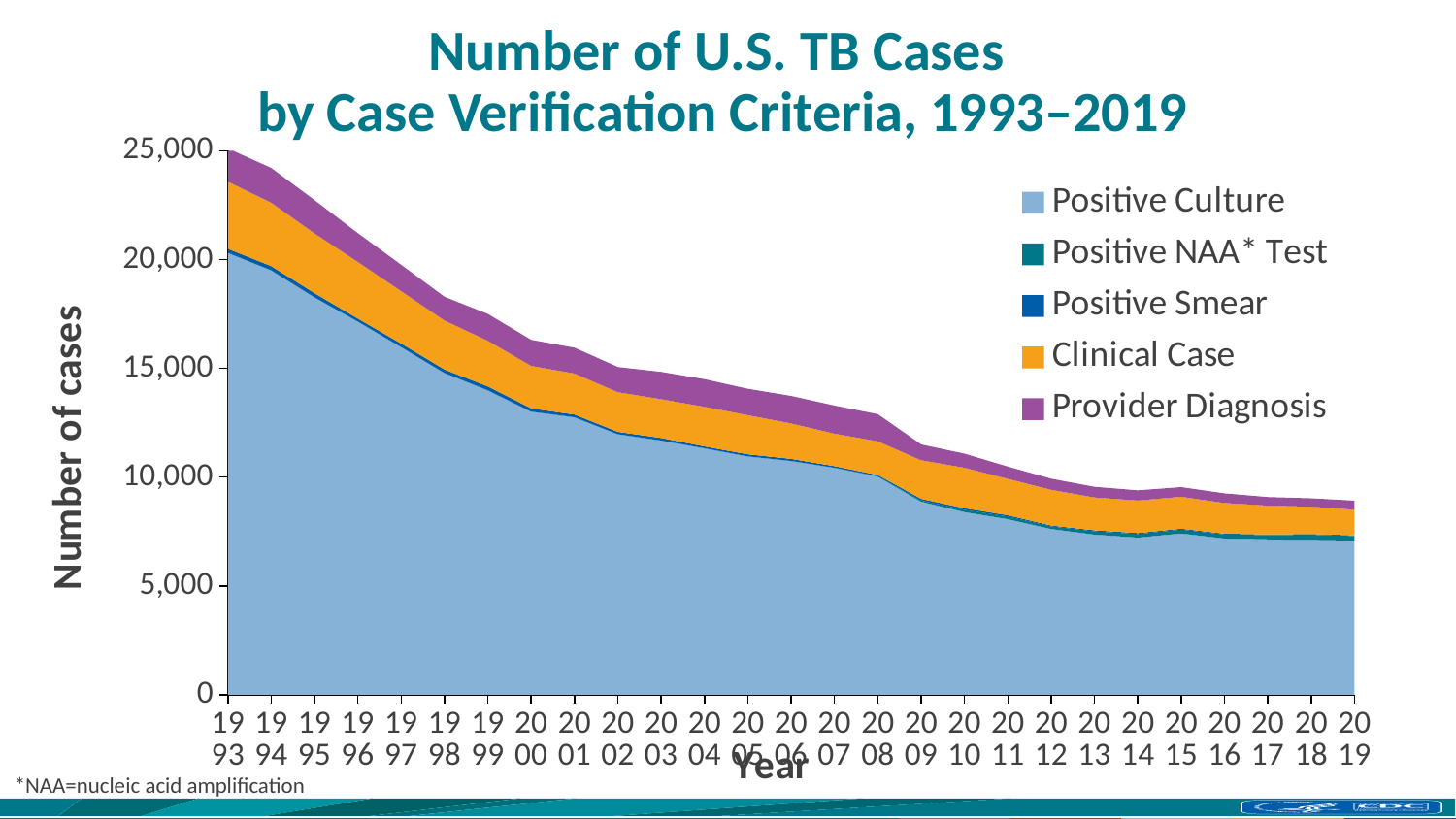
Which year has the highest total number of TB cases? 1993 Is the total number of cases in 1998 greater or less than 15,000? greater Is the total number of cases in 2019 greater or less than 10,000? less What kind of chart is shown on the slide? Stacked area chart How many series does the legend list? 5 Which year has the larger total number of cases, 1993 or 2019? 1993 Which series is shown in orange in the legend? Clinical Case Is the total number of cases in 1993 greater or less than 20,000? greater What is the label of the y axis? Number of cases Do the total number of TB cases rise or fall from 1993 to 2019? Fall How many years are plotted along the x axis? 27